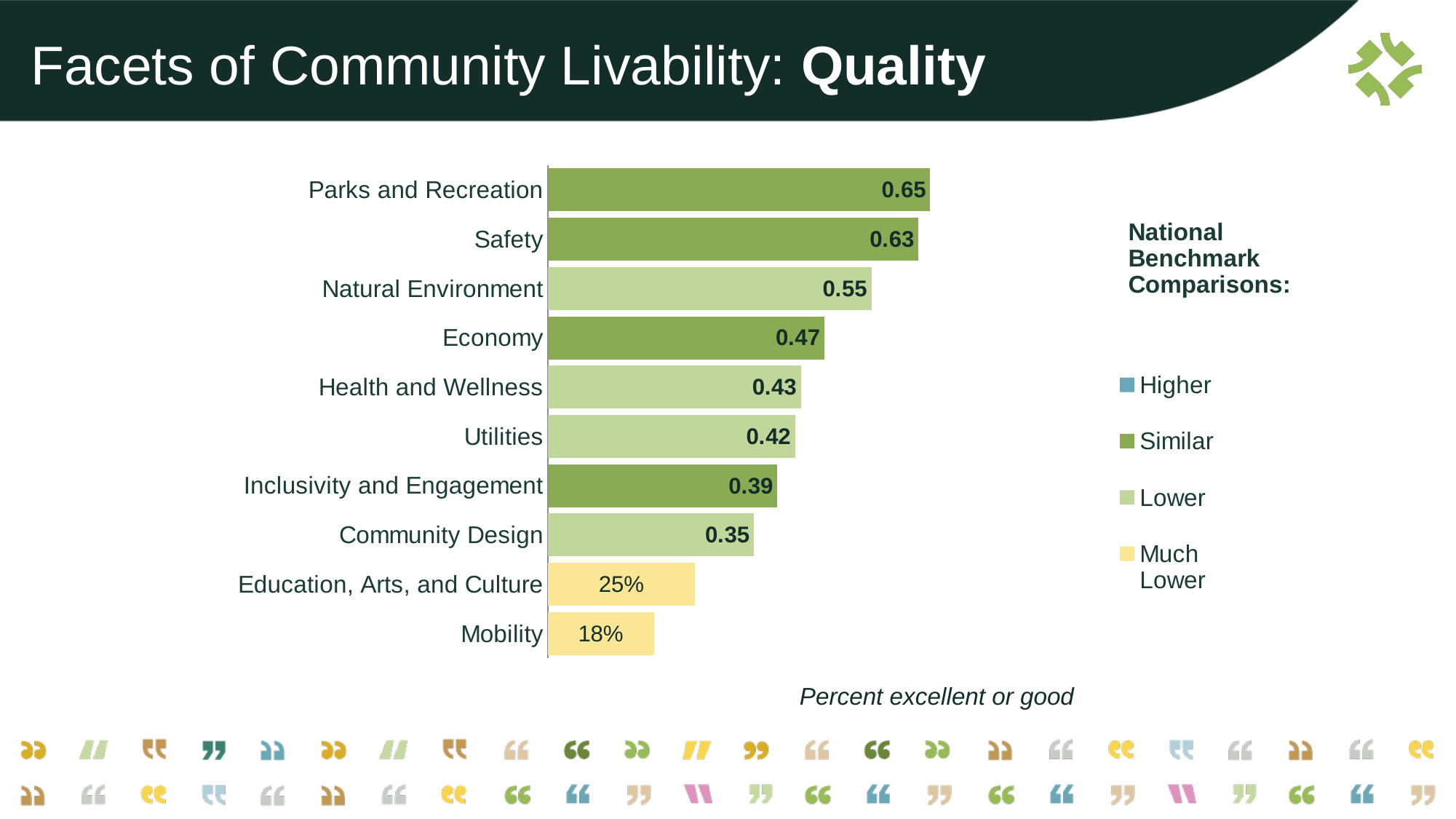
What is the difference between the values for Parks and Recreation and Safety? 0.02 Which category has the lowest value? Mobility What is the difference between the values for Education, Arts, and Culture and Mobility? 7% What is the label printed below the chart? Percent excellent or good What is the value for Mobility? 18% Which is larger, the value for Economy or the value for Community Design? Economy What is the value for Parks and Recreation? 0.65 Which category has the highest value? Parks and Recreation How many entries does the legend list? 4 What kind of chart is shown on the slide? Bar chart What is the value for Inclusivity and Engagement? 0.39 How many categories are shown in the chart? 10